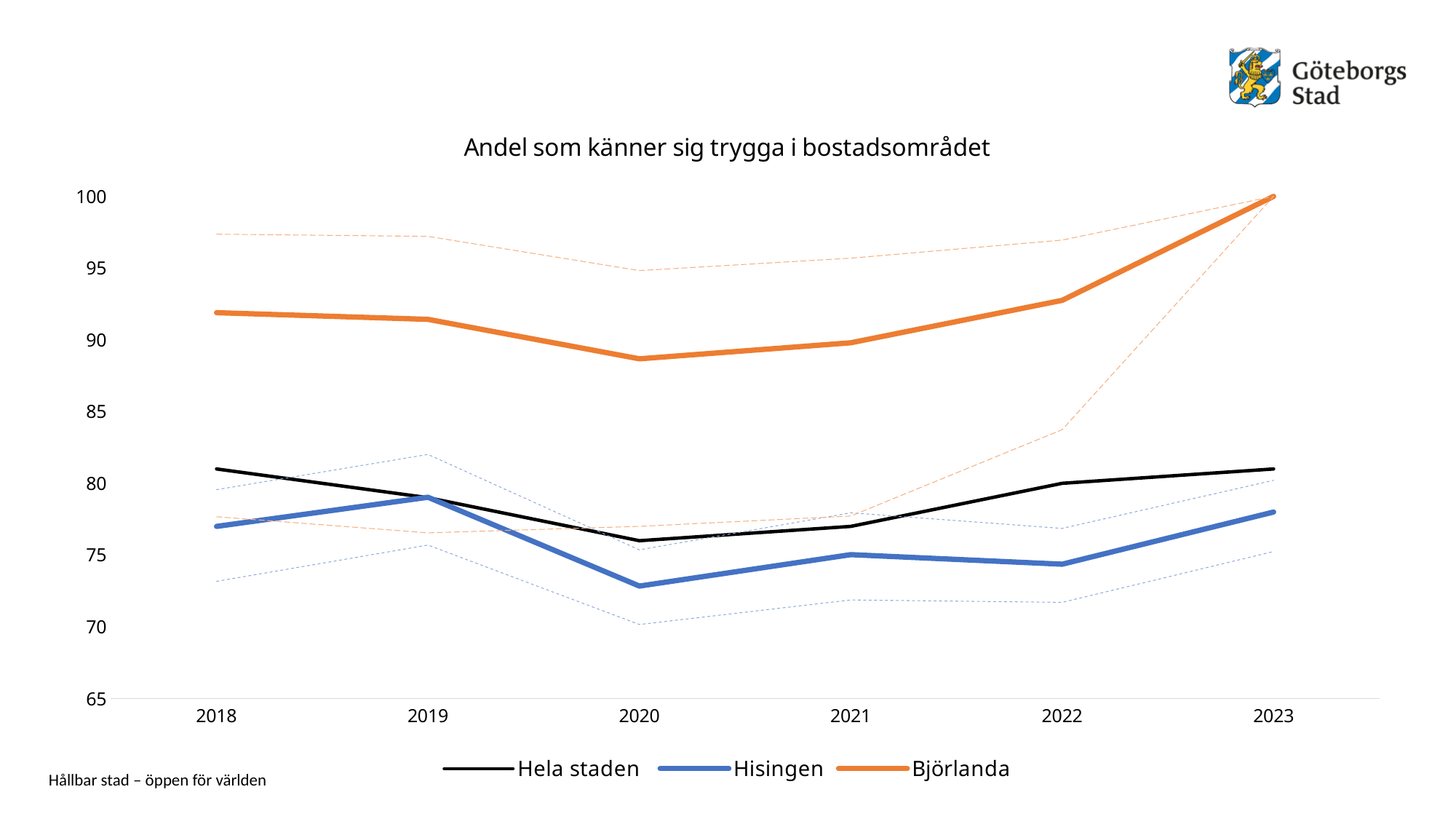
How many years are shown on the x axis? 6 Which is larger in 2022, the value for Hela staden or the value for Hisingen? Hela staden What is the title of the chart? Andel som känner sig trygga i bostadsområdet What kind of chart is shown on the slide? line chart Is the value for Björlanda in 2020 greater or less than 85? greater Is the value for Hela staden in 2018 greater or less than 80? greater Which series has the highest value in 2023? Björlanda How many series does the legend list? 3 Which series has the lowest value in 2020? Hisingen Does the Björlanda line rise or fall between 2020 and 2023? rise Is the value for Hisingen in 2020 greater or less than 75? less Which colour is used for the Hisingen line? blue